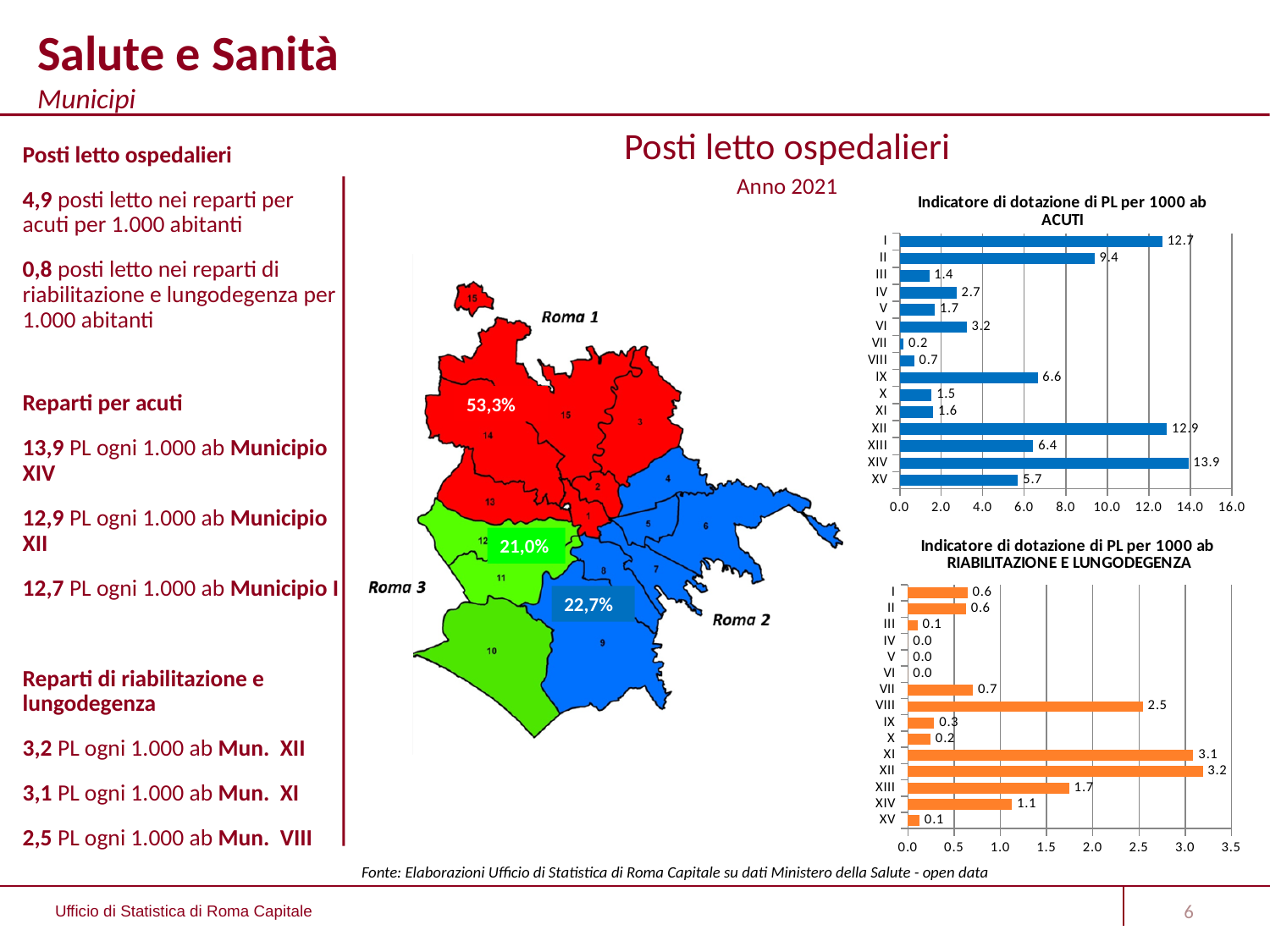
In the 'Indicatore di dotazione di PL per 1000 ab ACUTI' chart, what is the value for Municipio XIV? 13.9 In the 'Indicatore di dotazione di PL per 1000 ab RIABILITAZIONE E LUNGODEGENZA' chart, what is the value for Municipio VIII? 2.5 In the 'Indicatore di dotazione di PL per 1000 ab RIABILITAZIONE E LUNGODEGENZA' chart, which is larger, the value for Municipio XIII or Municipio XIV? Municipio XIII What type of chart is the 'Indicatore di dotazione di PL per 1000 ab RIABILITAZIONE E LUNGODEGENZA' chart? Bar chart In the 'Indicatore di dotazione di PL per 1000 ab ACUTI' chart, what is the value for Municipio II? 9.4 In the 'Indicatore di dotazione di PL per 1000 ab ACUTI' chart, how many municipi are shown? 15 In the 'Indicatore di dotazione di PL per 1000 ab ACUTI' chart, which municipio has the highest value? XIV In the 'Indicatore di dotazione di PL per 1000 ab RIABILITAZIONE E LUNGODEGENZA' chart, what is the difference between the values for Municipio XII and Municipio VIII? 0.7 In the 'Indicatore di dotazione di PL per 1000 ab ACUTI' chart, which municipio has the lowest value? VII In the 'Indicatore di dotazione di PL per 1000 ab ACUTI' chart, what is the difference between the values for Municipio XIV and Municipio XII? 1.0 In the 'Indicatore di dotazione di PL per 1000 ab ACUTI' chart, which is larger, the value for Municipio II or Municipio IX? Municipio II In the 'Indicatore di dotazione di PL per 1000 ab RIABILITAZIONE E LUNGODEGENZA' chart, what is the value for Municipio XIII? 1.7